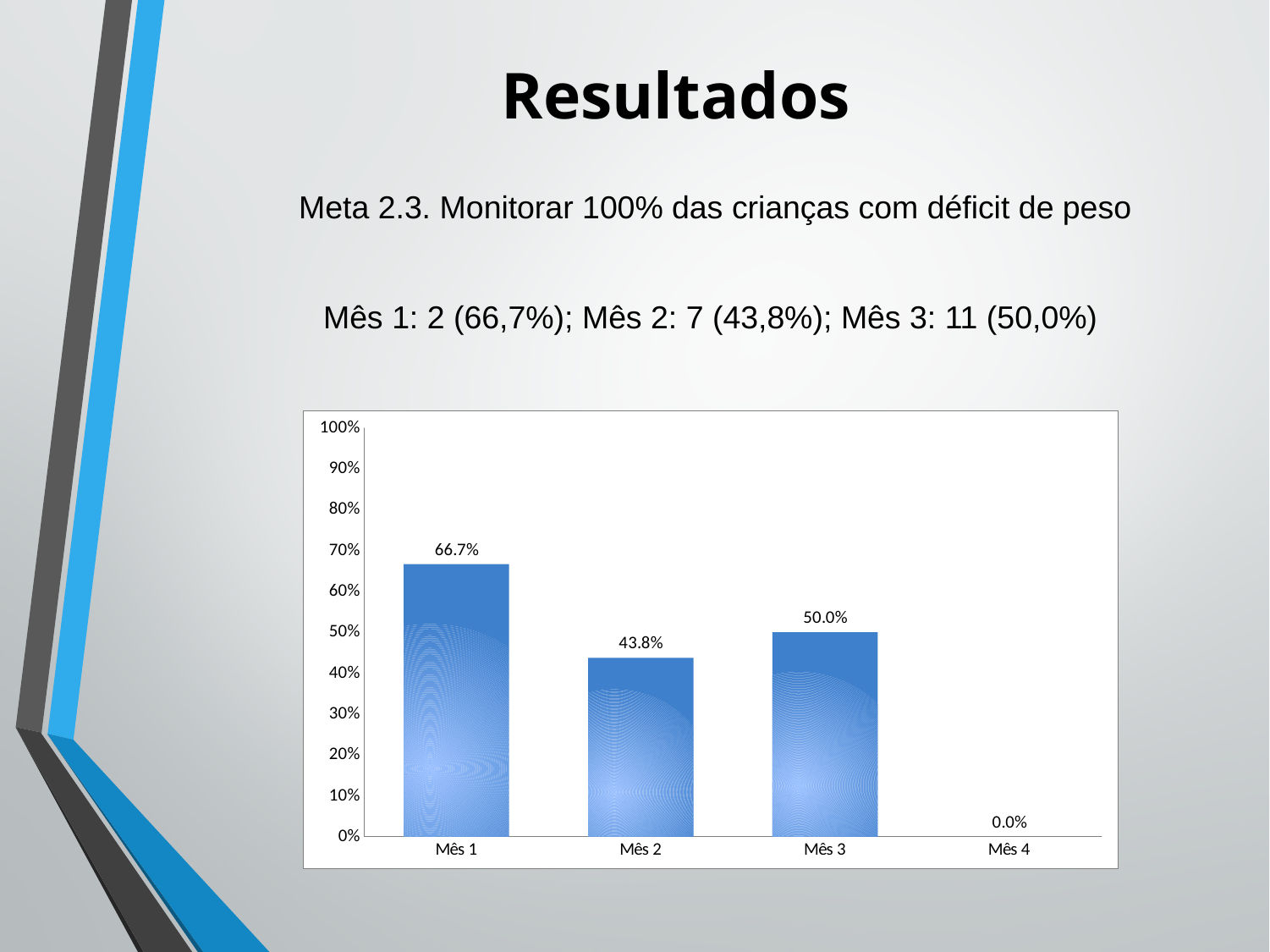
What kind of chart is shown? bar chart What is the difference between the values for Mês 1 and Mês 2? 22.9% What is the value for Mês 1? 66.7% What is the value for Mês 3? 50.0% Is the value for Mês 1 greater or less than 60%? greater What is the value for Mês 2? 43.8% Which category has the highest value? Mês 1 What is the value for Mês 4? 0.0% Which category has the lowest value? Mês 4 Which is larger, the value for Mês 2 or Mês 3? Mês 3 What is the highest value shown on the y axis? 100% How many categories are shown on the x axis? 4